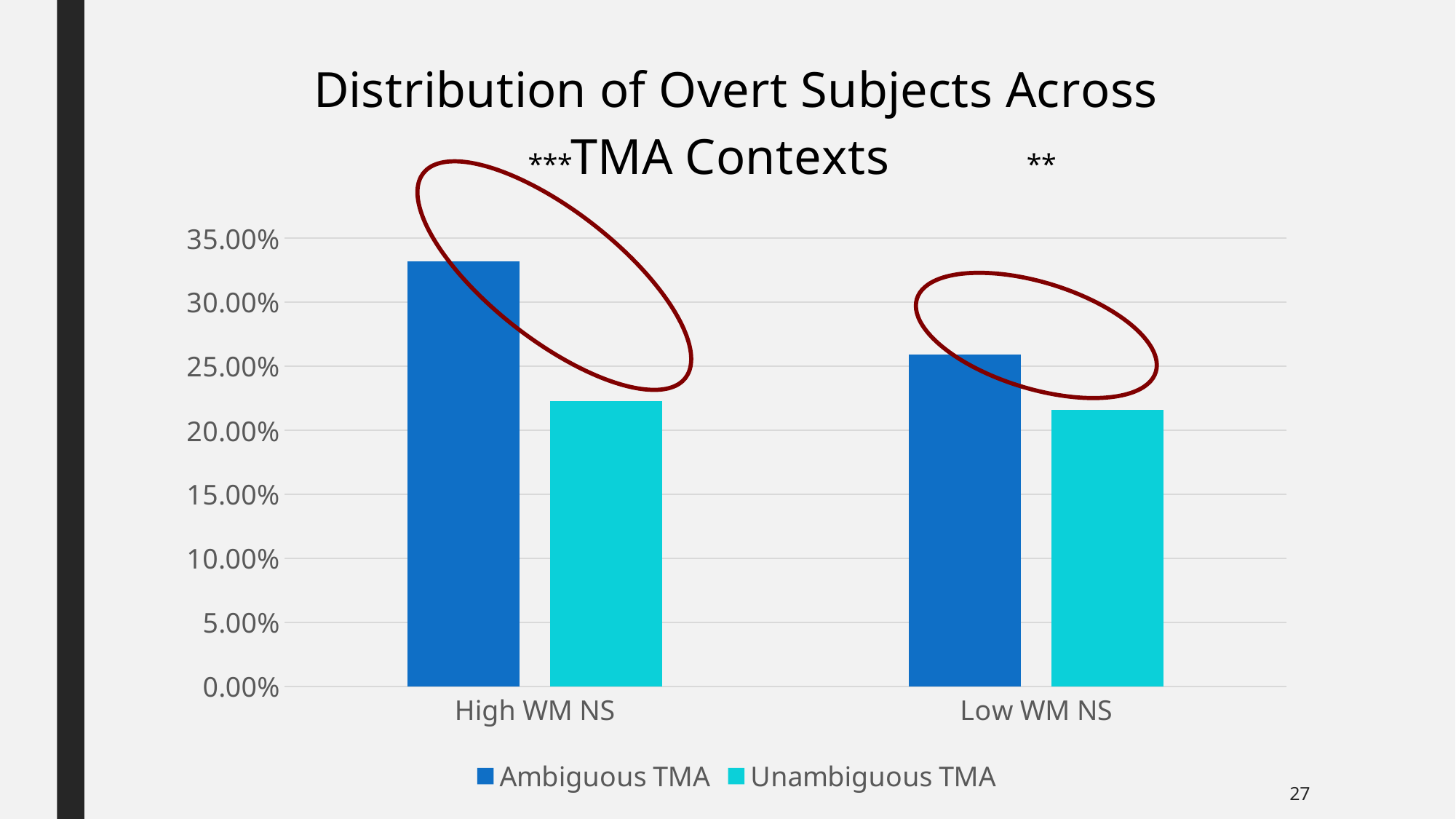
For High WM NS, which is larger: Ambiguous TMA or Unambiguous TMA? Ambiguous TMA For Low WM NS, which is larger: Ambiguous TMA or Unambiguous TMA? Ambiguous TMA Which category has the lower Ambiguous TMA value? Low WM NS Which bar is the highest in the chart? Ambiguous TMA for High WM NS How many categories are shown on the x axis? 2 Is the Unambiguous TMA value for High WM NS greater or less than 25.00%? less What is the title of the chart? Distribution of Overt Subjects Across TMA Contexts How many series does the legend list? 2 Which series is shown in the lighter cyan colour? Unambiguous TMA What kind of chart is shown on the slide? Bar chart Is the Unambiguous TMA value for Low WM NS greater or less than 20.00%? greater Is the Ambiguous TMA value for High WM NS greater or less than 30.00%? greater